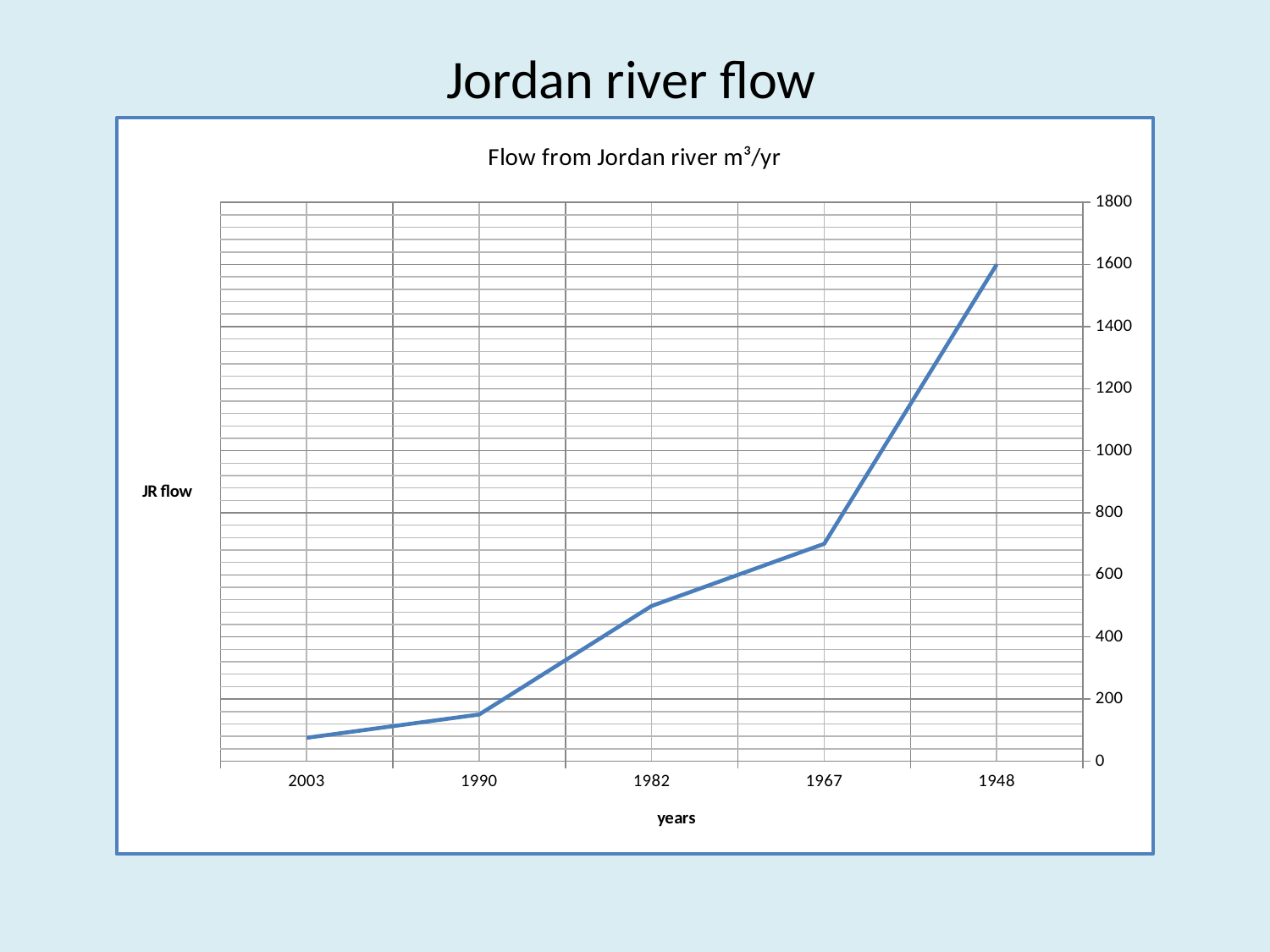
Which has the larger flow value, 1982 or 1990? 1982 Do the plotted values rise or fall moving from left to right along the x axis? rise Which year has the highest flow value? 1948 What is the title of the chart? Flow from Jordan river m³/yr What is the label on the x axis of the chart? years Which year has the lowest flow value? 2003 Is the value for 2003 greater or less than 200? less Is the value for 1948 greater or less than 1400? greater How many years are plotted along the x axis? 5 Is the value for 1967 greater or less than 800? less What kind of chart is shown on the slide? line chart Which has the larger flow value, 1948 or 1967? 1948